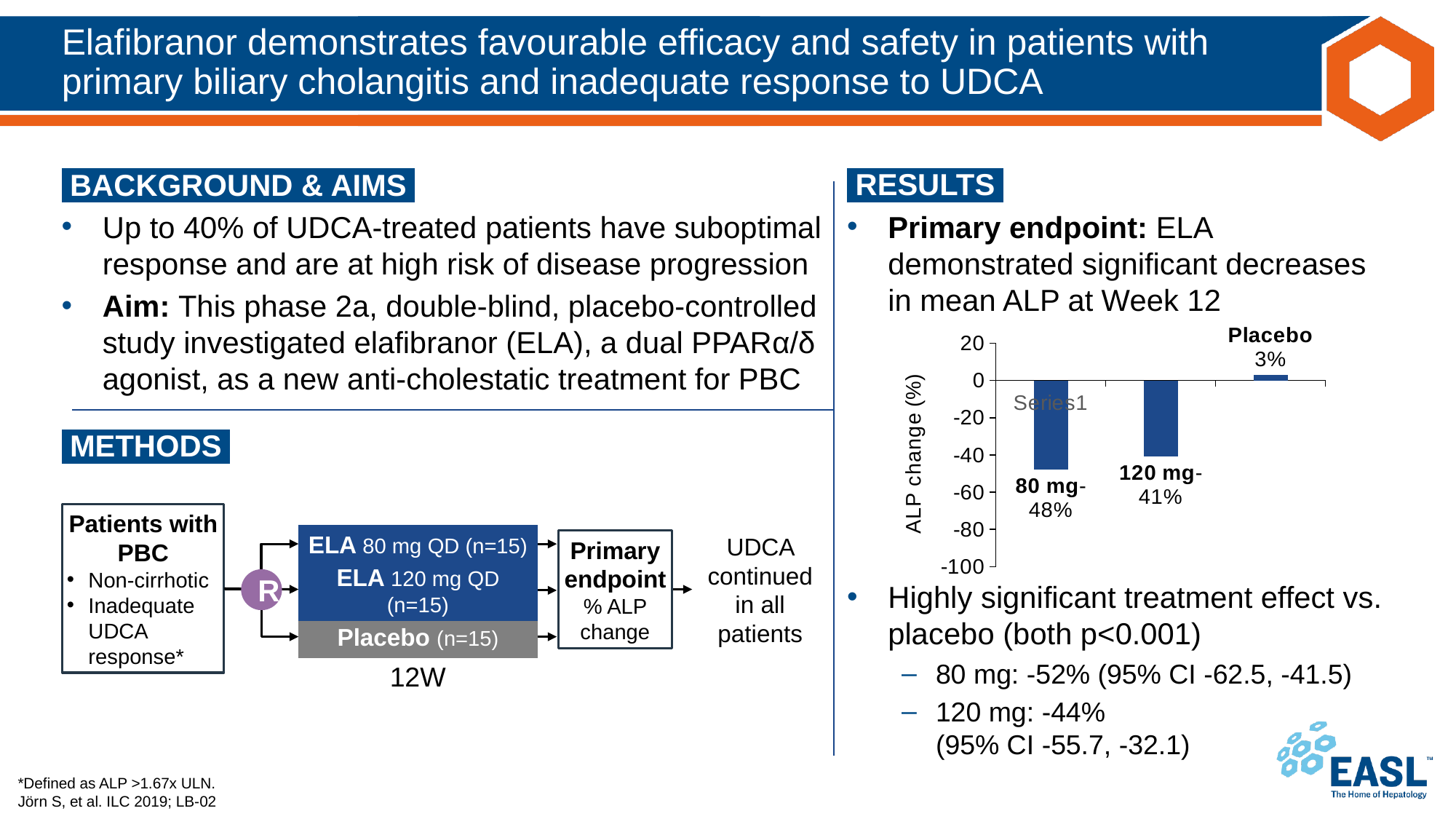
What is the ALP change (%) for the Placebo group in the chart? 3% What is the label of the y-axis in the chart? ALP change (%) What is the difference in ALP change between the 80 mg and 120 mg groups? 7 percentage points Which group has the highest ALP change value in the chart? Placebo What is the lowest value shown on the y-axis of the chart? -100 Which group shows the largest decrease in ALP in the chart? 80 mg What type of chart is used to show ALP change? Bar chart What is the ALP change (%) for the 120 mg group in the chart? -41% Which group has a larger ALP change value, 120 mg or Placebo? Placebo How many bars are plotted in the chart? 3 What is the ALP change (%) for the 80 mg group in the chart? -48% Is the ALP change for the 80 mg group greater or less than -40? less